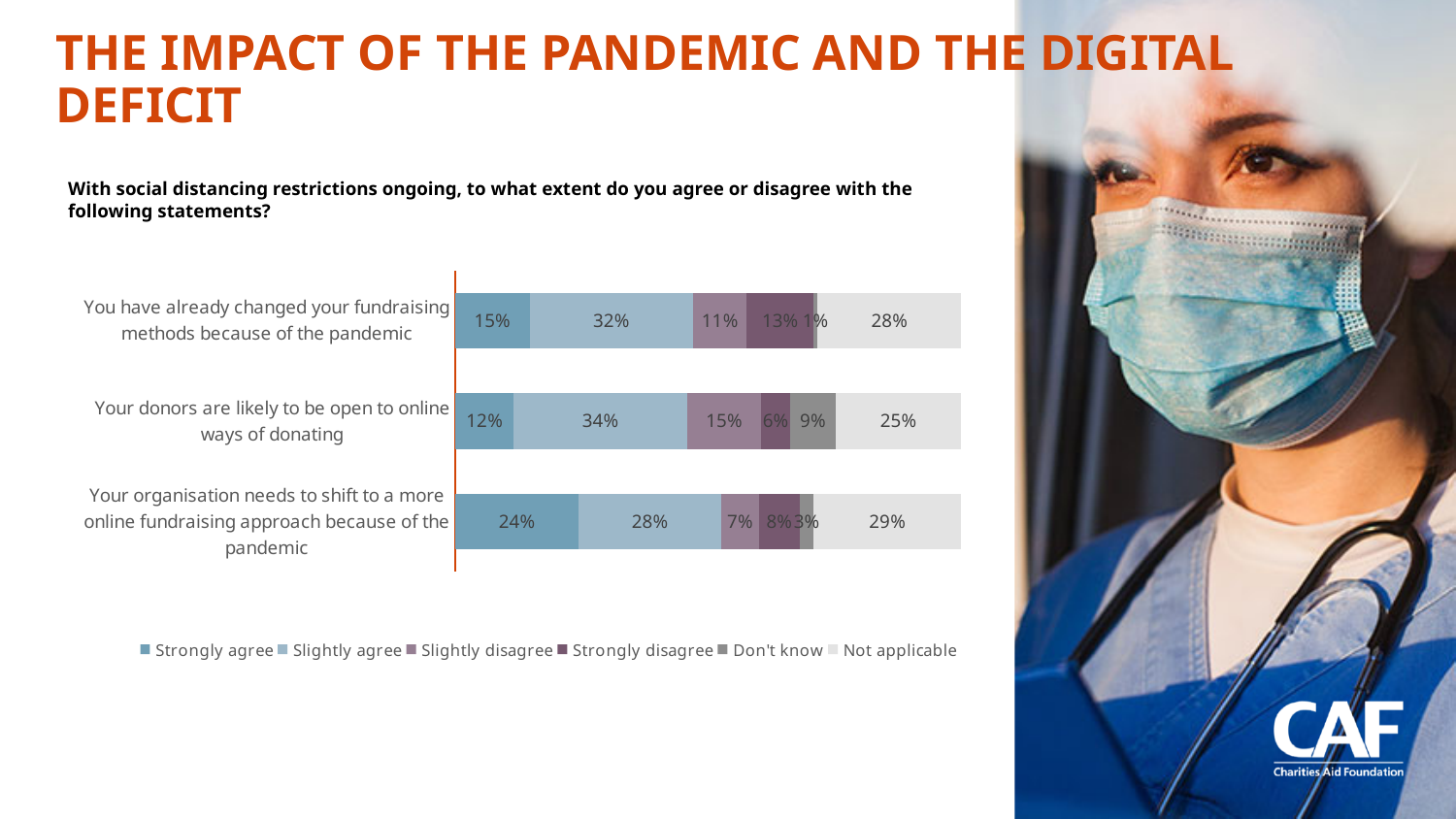
Which statement has the highest 'Strongly agree' percentage? Your organisation needs to shift to a more online fundraising approach because of the pandemic Which statement has the lowest 'Don't know' percentage? You have already changed your fundraising methods because of the pandemic What is the 'Not applicable' value for the statement 'You have already changed your fundraising methods because of the pandemic'? 28% How many response categories does the legend list? 6 What percentage slightly agree that their donors are likely to be open to online ways of donating? 34% What percentage strongly agree that their organisation needs to shift to a more online fundraising approach because of the pandemic? 24% What percentage strongly disagree that they have already changed their fundraising methods because of the pandemic? 13% What type of chart is shown on the slide? Stacked bar chart Which has a larger 'Slightly agree' share: 'You have already changed your fundraising methods' or 'Your donors are likely to be open to online ways of donating'? Your donors are likely to be open to online ways of donating Which response category is listed first in the legend? Strongly agree How many statements are shown in the chart? 3 What is the difference in 'Strongly agree' percentage between 'Your organisation needs to shift to a more online fundraising approach' and 'Your donors are likely to be open to online ways of donating'? 12 percentage points